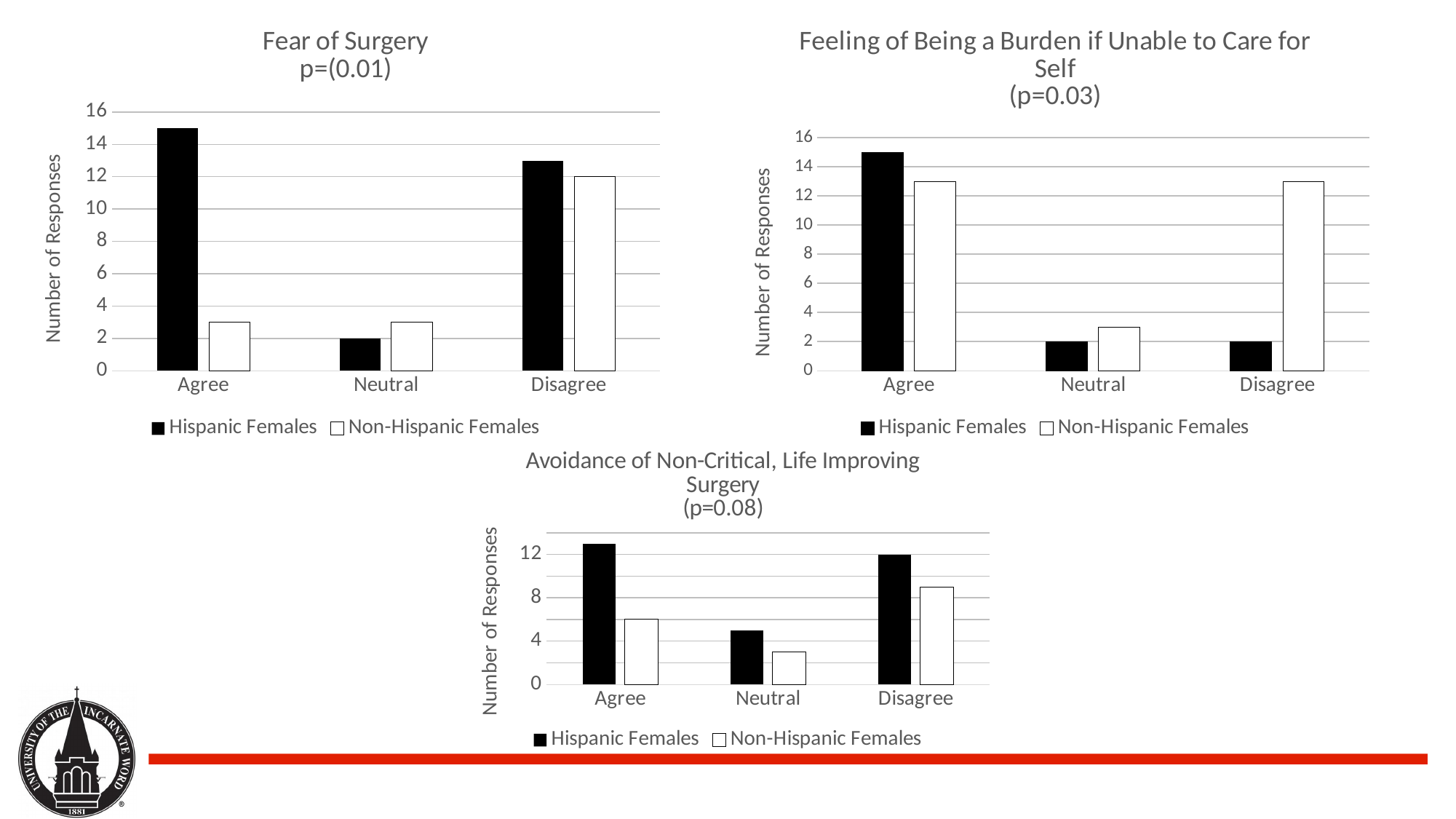
In the Fear of Surgery chart, which series has the larger value in the Agree category, Hispanic Females or Non-Hispanic Females? Hispanic Females In the Avoidance of Non-Critical, Life Improving Surgery chart, is the value for Non-Hispanic Females in the Agree category greater or less than 8? less In the Avoidance of Non-Critical, Life Improving Surgery chart, what is the value for Hispanic Females in the Disagree category? 12 In the Feeling of Being a Burden if Unable to Care for Self chart, is the value for Non-Hispanic Females in the Disagree category greater or less than 12? greater In the Fear of Surgery chart, which category has the highest value for Hispanic Females? Agree How many categories are shown on the x axis of the Avoidance of Non-Critical, Life Improving Surgery chart? 3 In the Fear of Surgery chart, what is the value for Hispanic Females in the Neutral category? 2 How many series does the legend of the Feeling of Being a Burden if Unable to Care for Self chart list? 2 In the Feeling of Being a Burden if Unable to Care for Self chart, what is the value for Hispanic Females in the Disagree category? 2 In the Fear of Surgery chart, what is the value for Non-Hispanic Females in the Disagree category? 12 In the Fear of Surgery chart, is the value for Hispanic Females in the Agree category greater or less than 14? greater In the Feeling of Being a Burden if Unable to Care for Self chart, which category has the lowest value for Non-Hispanic Females? Neutral